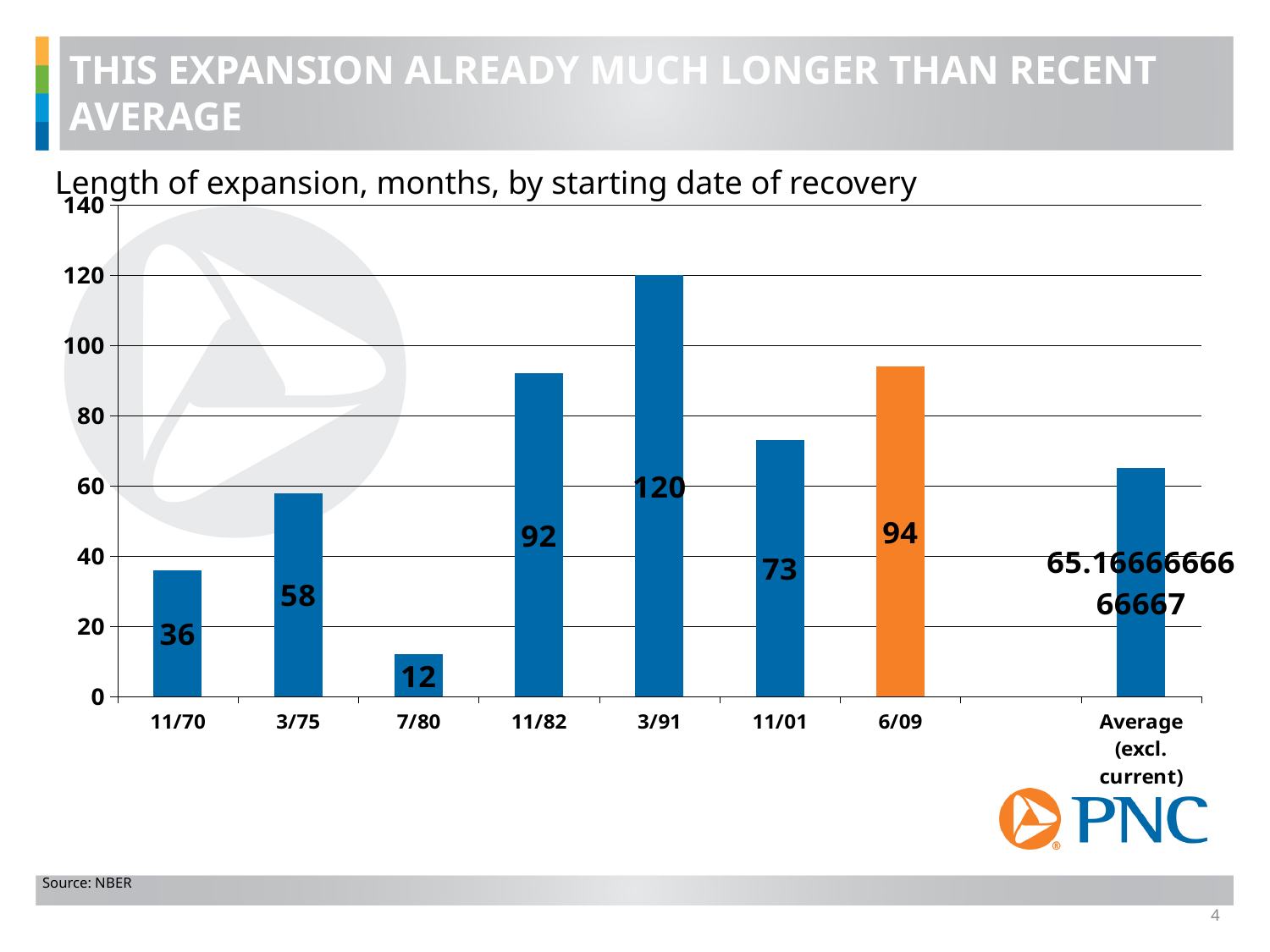
Which bar is coloured orange instead of blue? 6/09 What value is shown for the Average (excl. current) bar? 65.1666666666667 Which starting date has the shortest expansion? 7/80 What is the length of expansion for the recovery starting 3/91? 120 What is the title of the chart? Length of expansion, months, by starting date of recovery Which expansion is longer, the one starting 11/82 or the one starting 3/75? 11/82 How many months longer is the 6/09 expansion than the 11/01 expansion? 21 Which starting date has the longest expansion? 3/91 What is the length of expansion for the recovery starting 7/80? 12 What is the length of expansion for the recovery starting 6/09? 94 How many bars are plotted in the chart? 8 What type of chart is shown on the slide? Bar chart